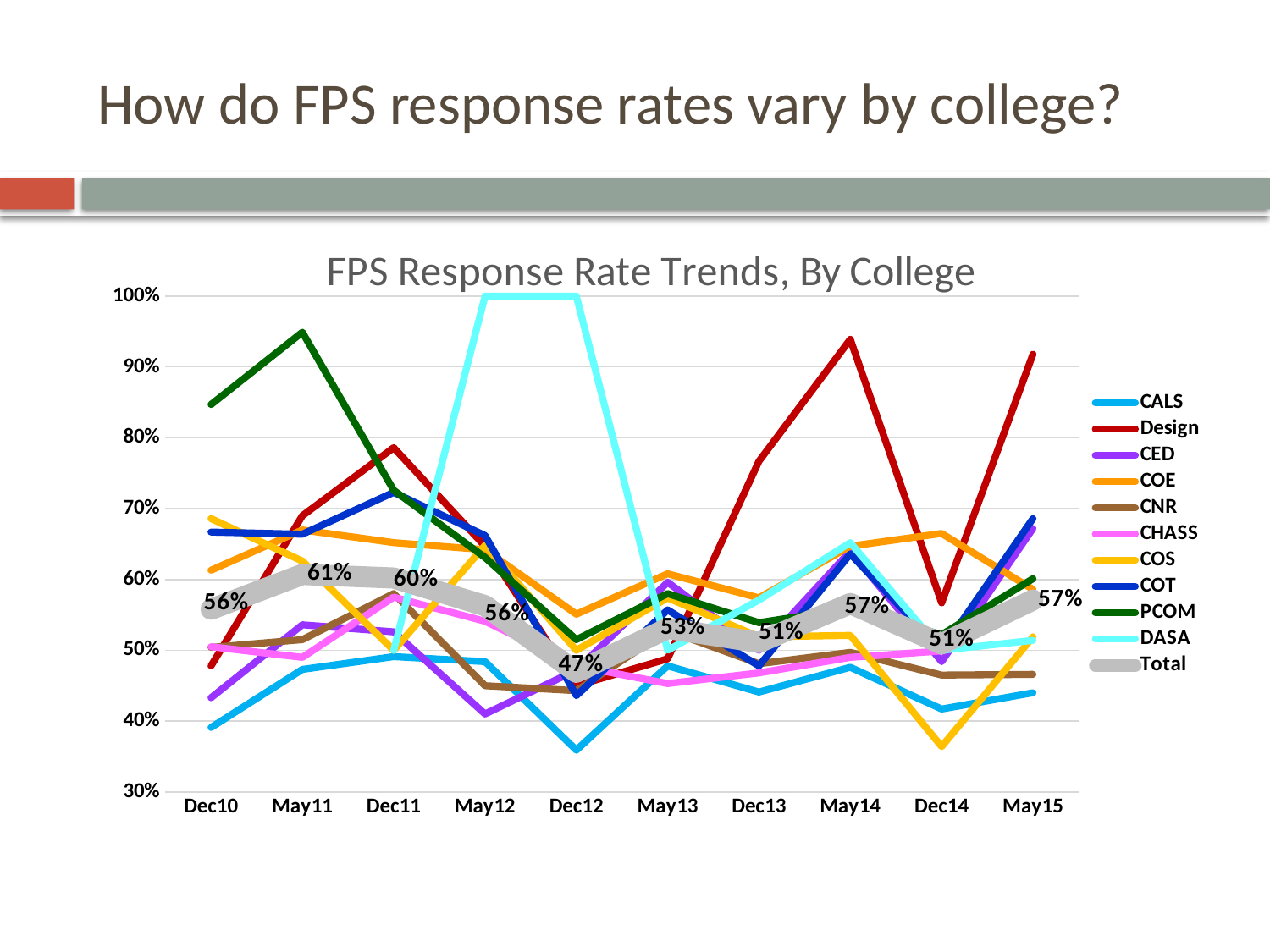
What is the difference between the Total response rate at May11 and at Dec12? 14 percentage points Is the value for DASA at May12 greater or less than 90%? greater Is the value for CALS at Dec12 greater or less than 40%? less At which time point is the Total response rate lowest? Dec12 What is the title of the chart? FPS Response Rate Trends, By College What kind of chart is shown on the slide? line chart What is the Total response rate at May11? 61% How many series does the legend list? 11 How many time points are shown along the x axis? 10 At which time point is the Total response rate highest? May11 Does the Total response rate rise or fall from Dec12 to May13? rise What is the Total response rate at Dec12? 47%